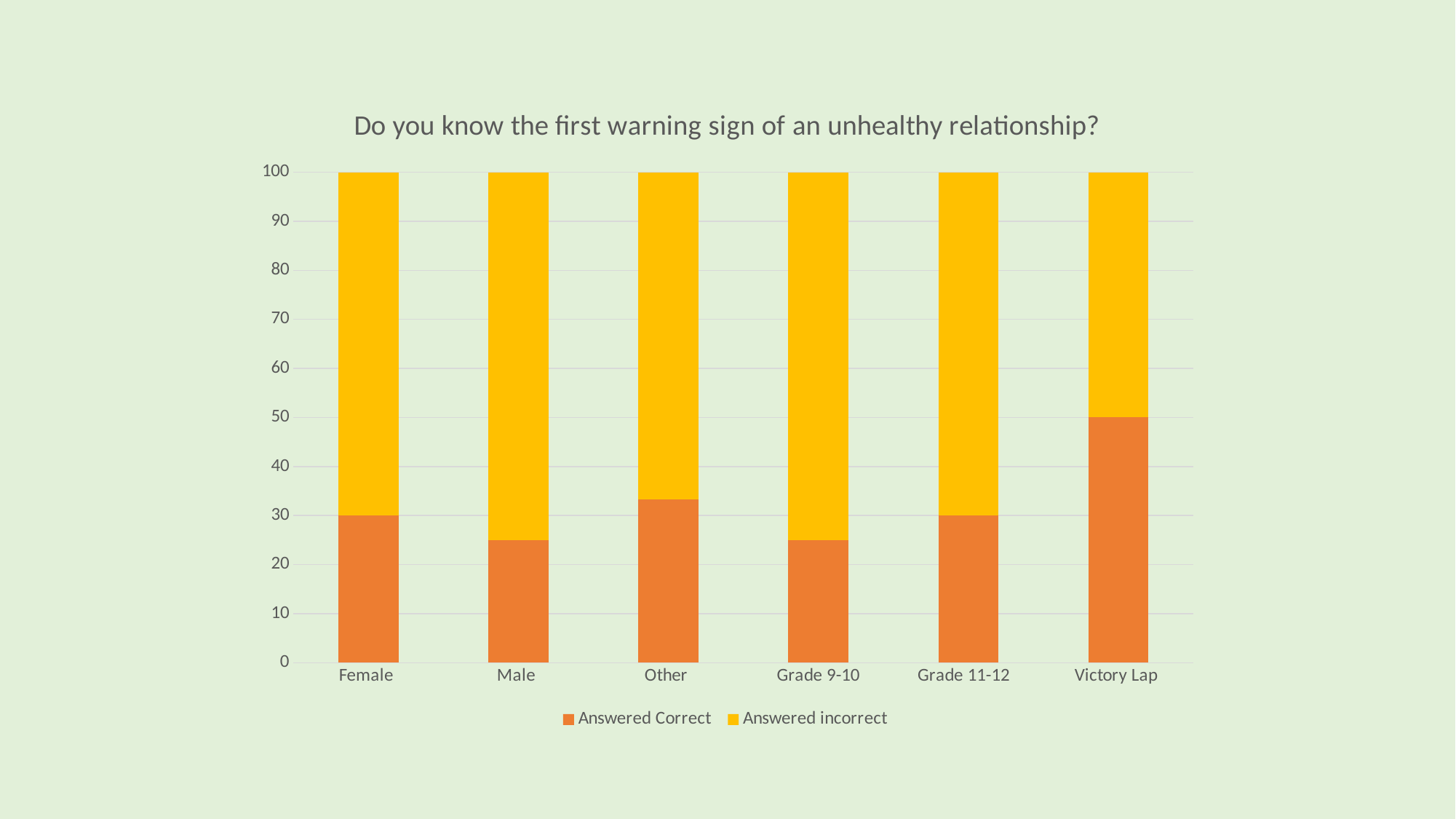
How many categories are shown on the x axis? 6 What is the total height of the stacked bar for Grade 11-12? 100 Is the Answered Correct value for Male greater or less than 30? less What is the Answered Correct value for Female? 30 What type of chart is shown on the slide? Stacked bar chart Which colour represents the Answered incorrect series? Yellow Which category has the highest Answered Correct value? Victory Lap What is the title of the chart? Do you know the first warning sign of an unhealthy relationship? Which has a larger Answered Correct value, Other or Grade 9-10? Other Is the Answered Correct value for Other greater or less than 30? greater How many series does the legend list? 2 What is the Answered Correct value for Victory Lap? 50